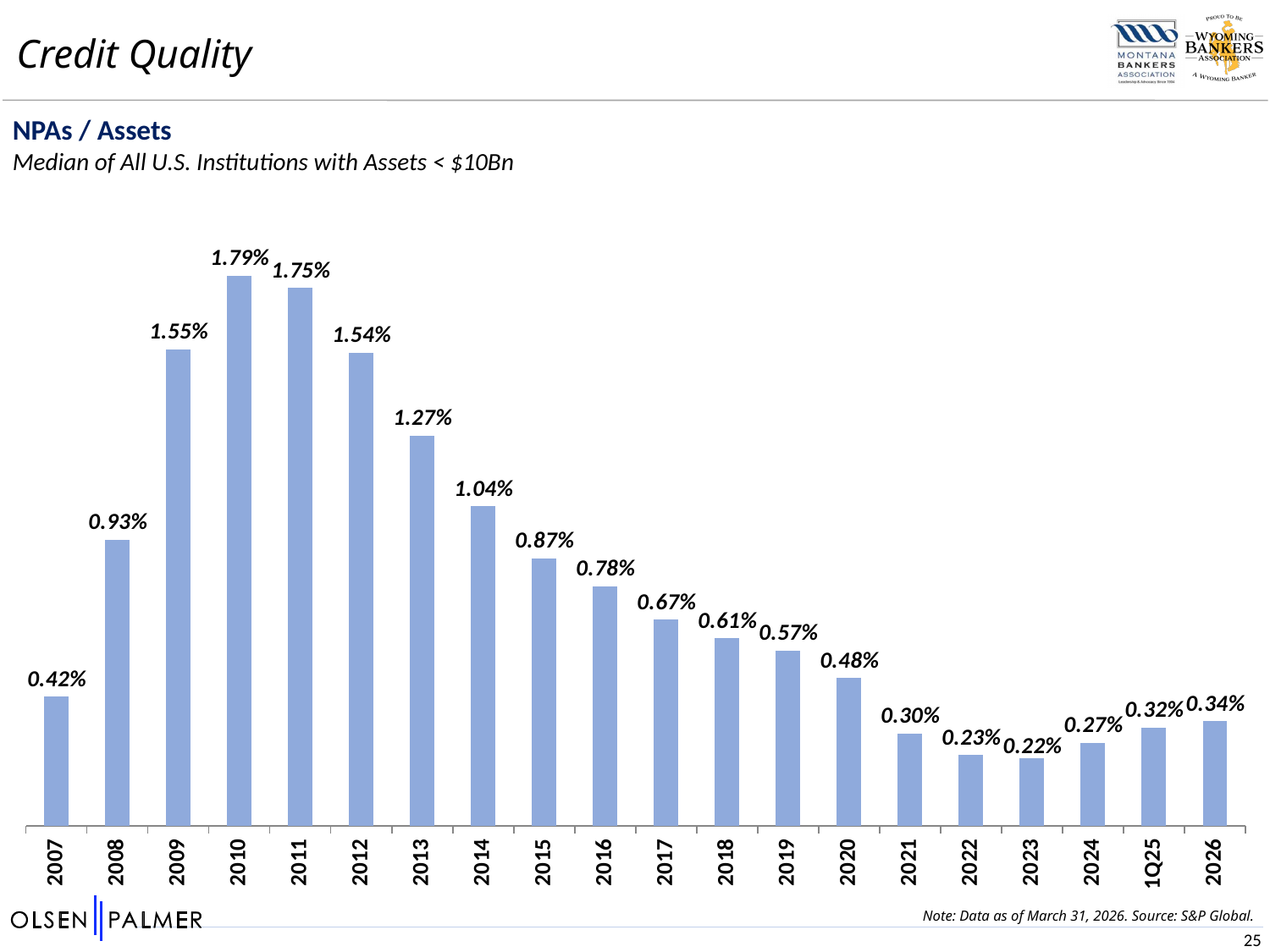
What is the NPAs / Assets value for 2007? 0.42% What is the difference between the NPAs / Assets values for 2010 and 2011? 0.04% Which year has the lowest NPAs / Assets value? 2023 What is the difference between the NPAs / Assets values for 2013 and 2014? 0.23% Do the NPAs / Assets values rise or fall from 2010 to 2023? Fall How many bars are shown in the NPAs / Assets chart? 20 What type of chart is used to show NPAs / Assets? Bar chart What is the NPAs / Assets value for 2010? 1.79% Which year has the highest NPAs / Assets value? 2010 What is the NPAs / Assets value for 2016? 0.78% What is the NPAs / Assets value for 1Q25? 0.32% Which is larger, the NPAs / Assets value for 2009 or for 2012? 2009